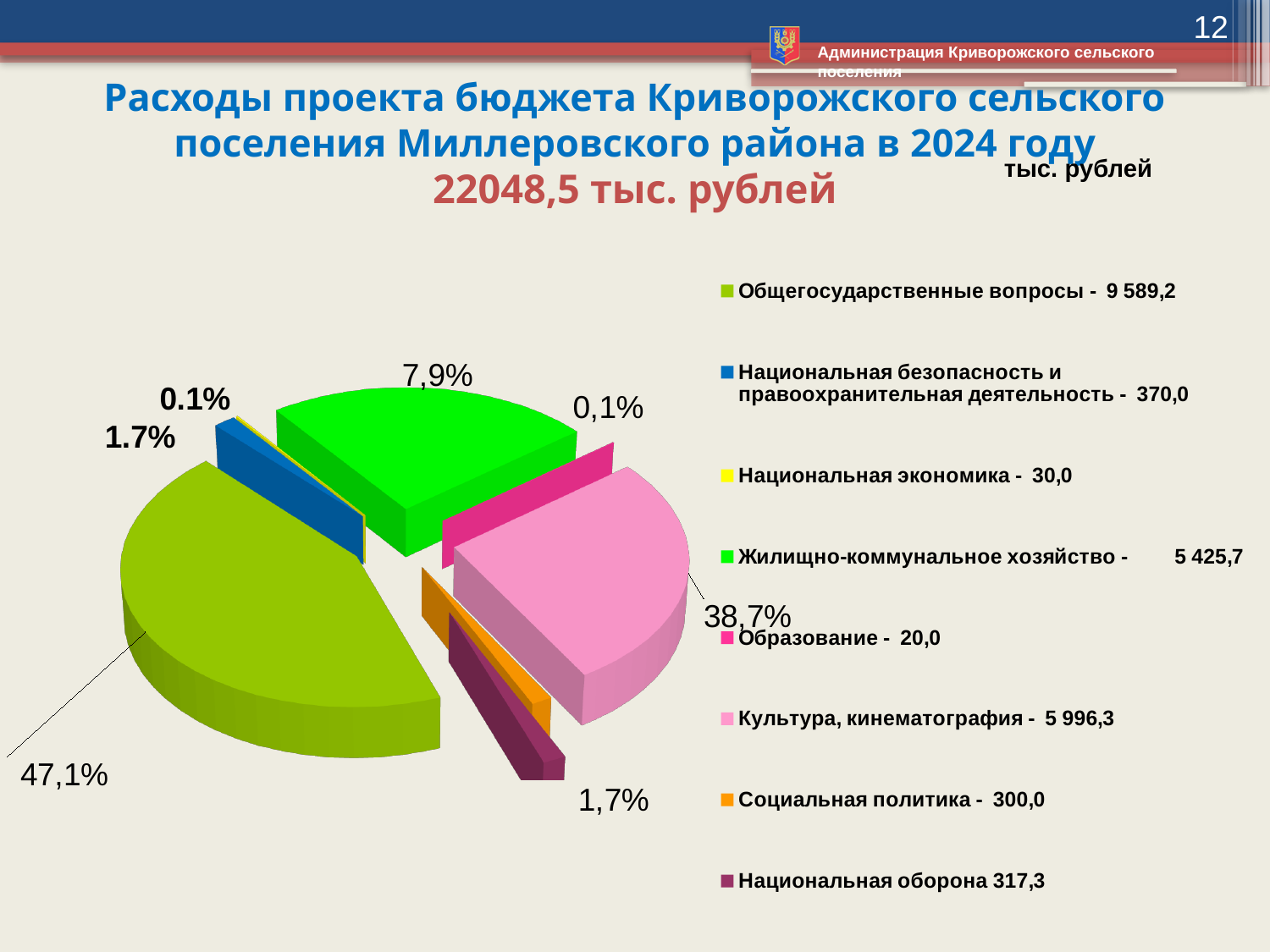
What is the value shown in the legend for Культура, кинематография? 5 996,3 What is the value shown in the legend for Национальная экономика? 30,0 What is the difference between the values for Культура, кинематография and Жилищно-коммунальное хозяйство? 570,6 What is the value shown in the legend for Национальная оборона? 317,3 What percentage share is labelled on the largest slice (Общегосударственные вопросы)? 47,1% What is the value shown in the legend for Общегосударственные вопросы? 9 589,2 How many expenditure categories does the legend list? 8 Which category has the smallest value? Образование Which is larger, Социальная политика or Национальная оборона? Национальная оборона What kind of chart is shown on the slide? pie chart Which category has the largest value? Общегосударственные вопросы What total expenditure amount is stated in the chart title? 22048,5 тыс. рублей